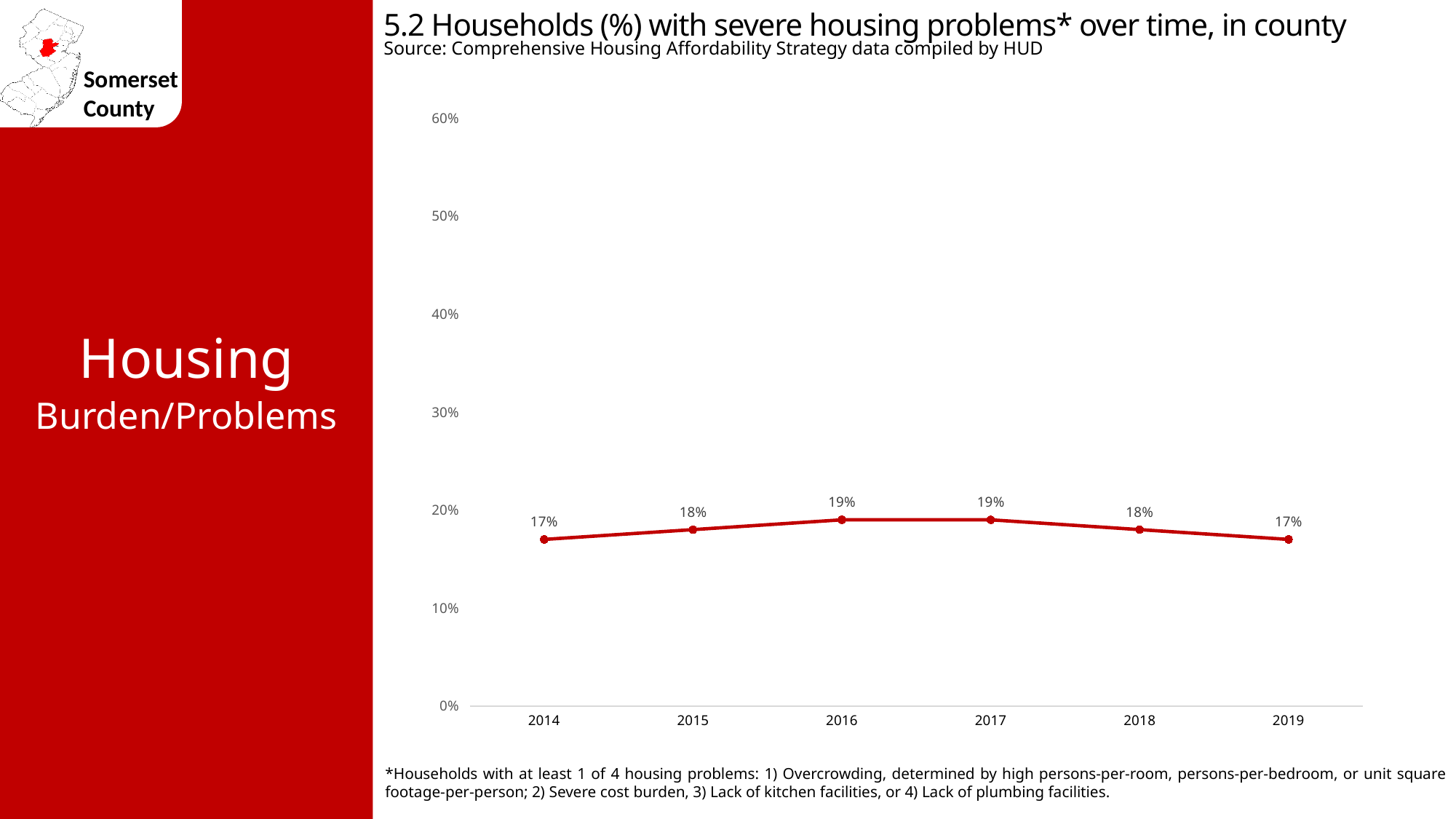
Does the value rise or fall from 2017 to 2019? fall Is the value for 2015 greater or less than the value for 2014? greater What is the title of the chart? 5.2 Households (%) with severe housing problems* over time, in county What is the value shown for 2016? 19% What is the difference between the 2016 value and the 2014 value? 2% What kind of chart is shown on the slide? line chart What is the value shown for 2019? 17% What is the source of the data shown in the chart? Comprehensive Housing Affordability Strategy data compiled by HUD What percentage of households had severe housing problems in 2018? 18% What percentage of households had severe housing problems in 2014? 17% How many years are plotted on the chart? 6 Is the value for 2017 greater or less than 20%? less